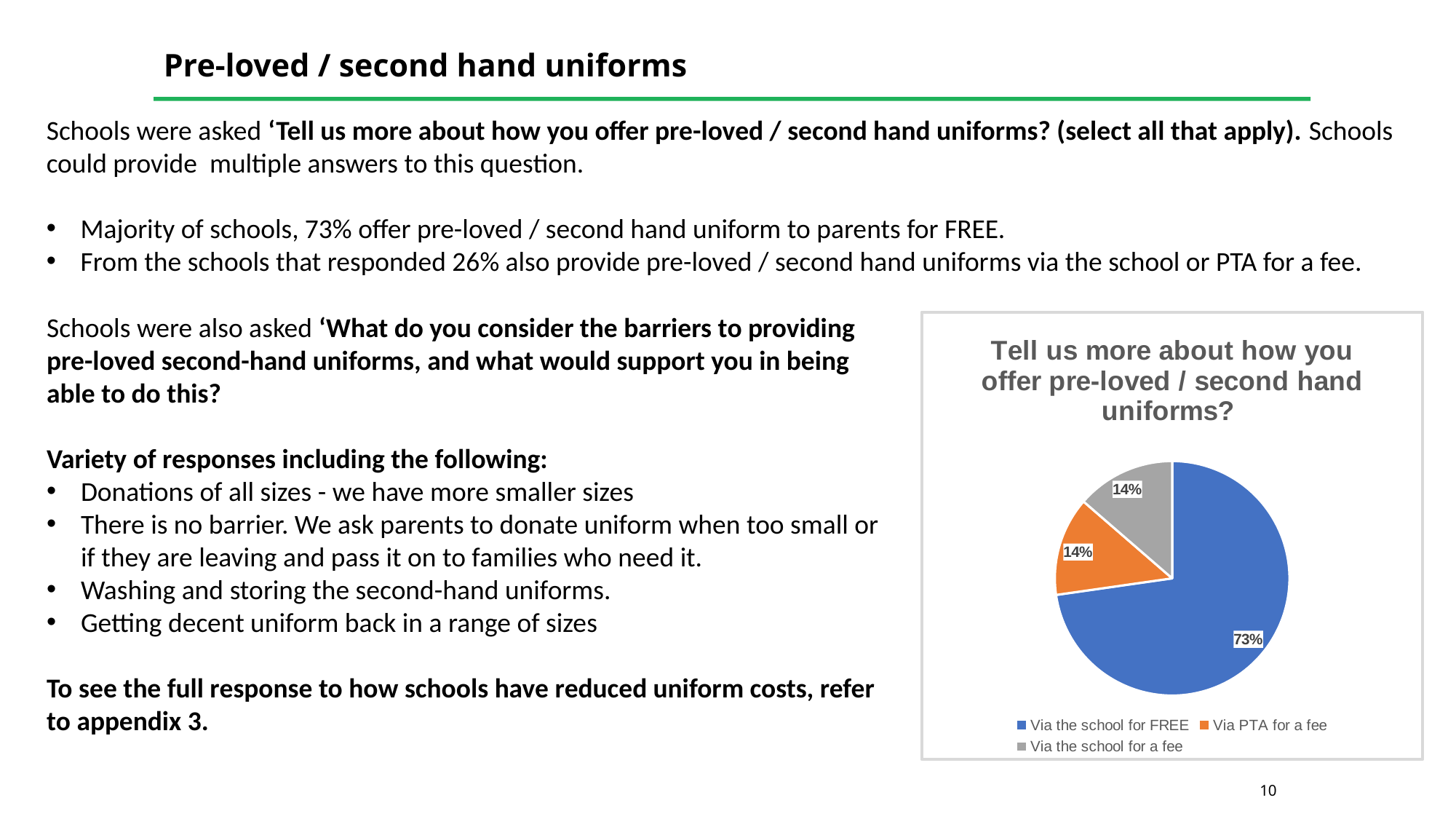
What percentage of the pie is labelled 'Via the school for a fee'? 14% What is the title of the pie chart? Tell us more about how you offer pre-loved / second hand uniforms? What colour is the slice for 'Via the school for FREE'? Blue What share of the pie do 'Via PTA for a fee' and 'Via the school for a fee' make up together? 28% What percentage of the pie is labelled 'Via the school for FREE'? 73% Which category has the largest slice of the pie? Via the school for FREE Which is larger: the slice for 'Via the school for FREE' or the slice for 'Via PTA for a fee'? Via the school for FREE How many slices does the pie chart have? 3 What kind of chart is shown on the slide? Pie chart What is the difference in percentage points between 'Via the school for FREE' and 'Via the school for a fee'? 59 percentage points What percentage of the pie is labelled 'Via PTA for a fee'? 14% How many entries does the chart legend list? 3